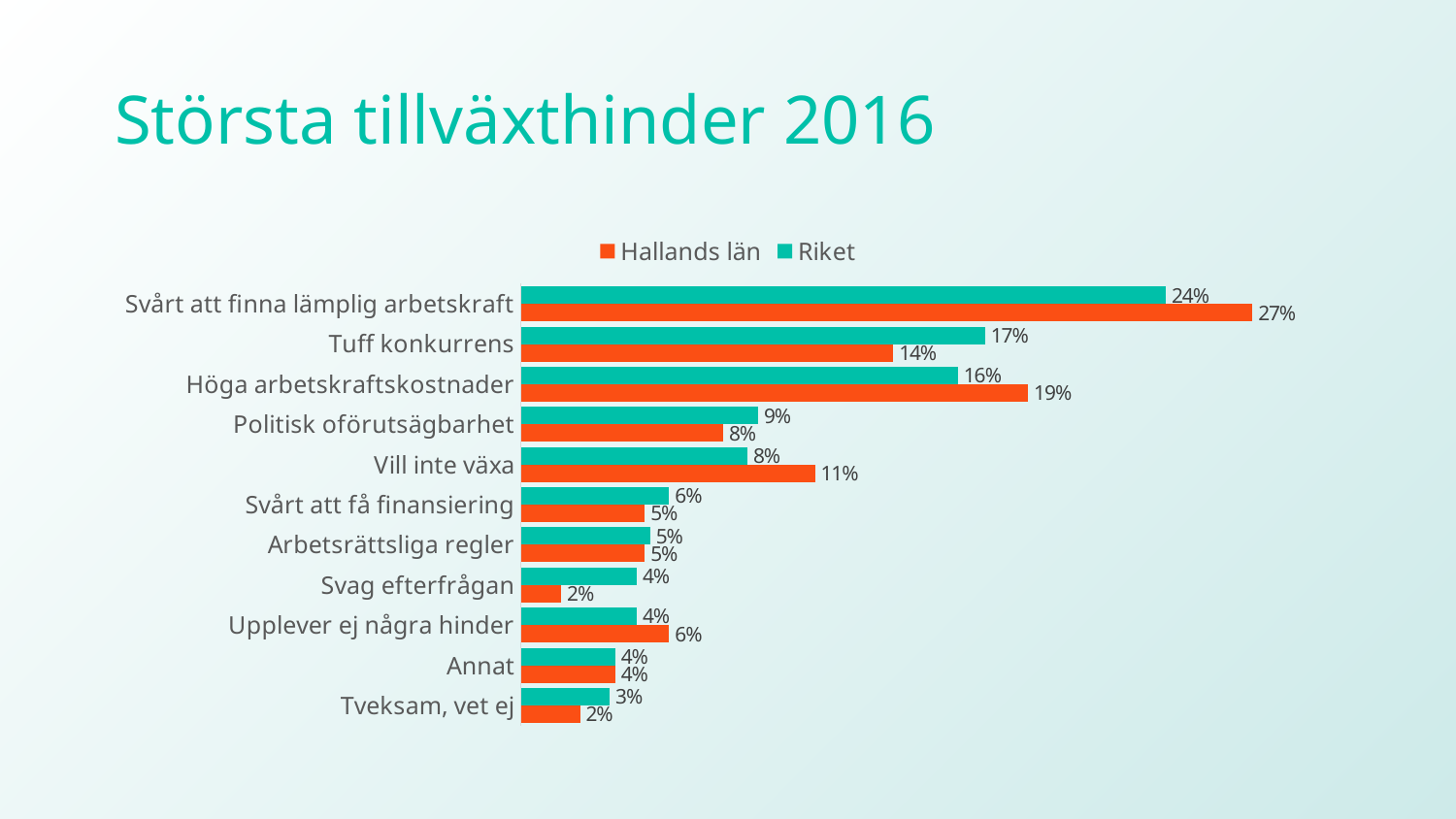
Which category has the highest value for Hallands län? Svårt att finna lämplig arbetskraft For "Upplever ej några hinder", which is larger: the Hallands län value or the Riket value? Hallands län Which colour represents Hallands län in the chart? Orange Which category has the lowest value for Riket? Tveksam, vet ej How many series does the legend list? 2 What is the value for Riket for "Tuff konkurrens"? 17% What kind of chart is shown on the slide? Bar chart How many categories are shown in the chart? 11 What is the value for Hallands län for "Vill inte växa"? 11% What is the difference between the Hallands län and Riket values for "Höga arbetskraftskostnader"? 3% What is the value for Hallands län for "Svårt att finna lämplig arbetskraft"? 27% For "Tuff konkurrens", which is larger: the Hallands län value or the Riket value? Riket